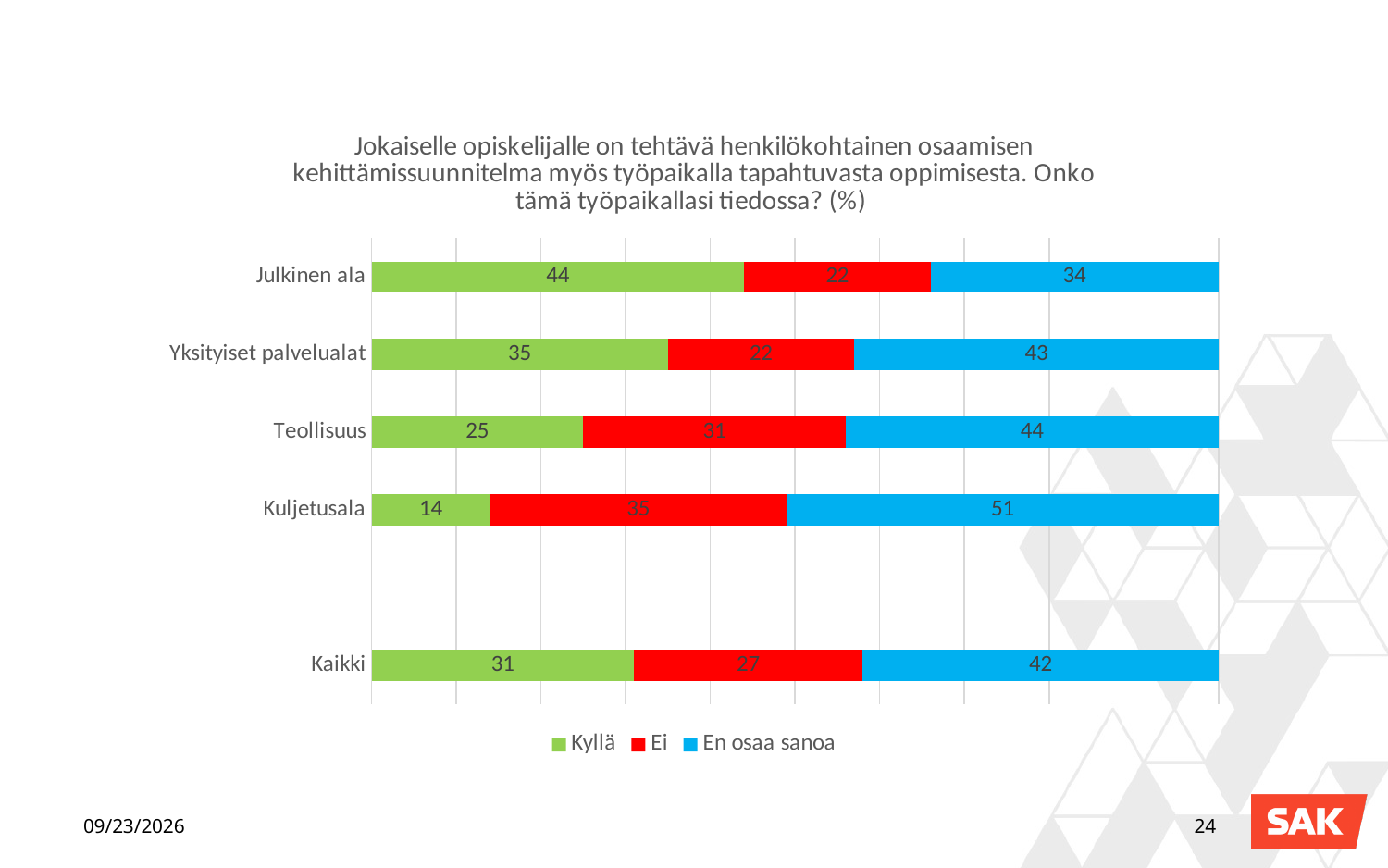
What is the En osaa sanoa value for Kuljetusala? 51 How many categories are shown on the chart? 5 What is the Kyllä value for Kaikki? 31 What is the Ei value for Teollisuus? 31 What kind of chart is shown on the slide? Stacked bar chart What is the total of the stacked bar for Teollisuus? 100 How many series does the legend list? 3 What is the Kyllä value for Julkinen ala? 44 What is the difference between the En osaa sanoa values for Kuljetusala and Julkinen ala? 17 Which category has the lowest Kyllä value? Kuljetusala Which category has the highest Kyllä value? Julkinen ala Which is larger, the Ei value for Kuljetusala or the Ei value for Yksityiset palvelualat? Kuljetusala